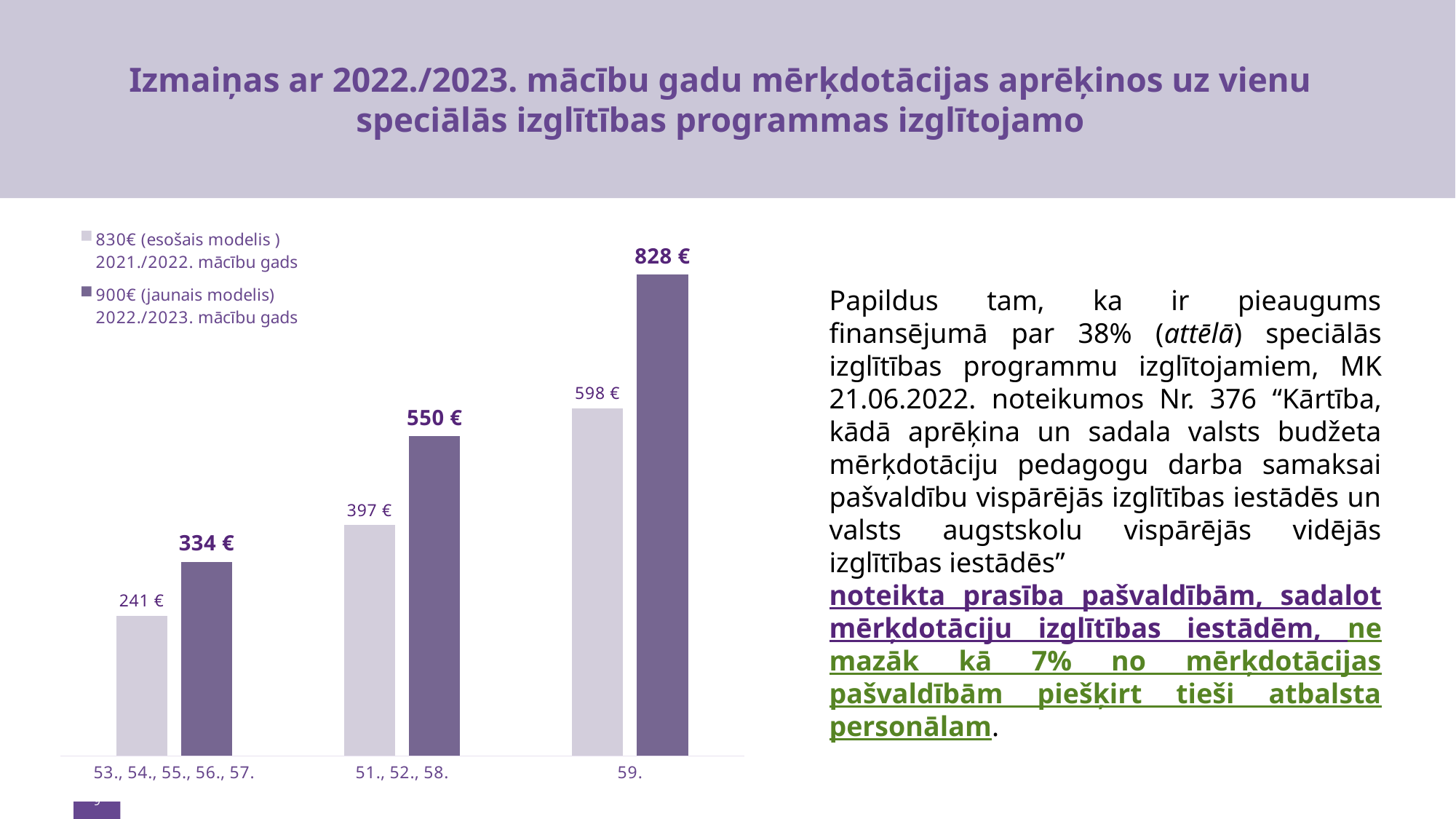
Which category has the lowest value for the 2021./2022. mācību gads series? 53., 54., 55., 56., 57. How many series does the chart legend list? 2 Which category has the highest value for the 2022./2023. mācību gads series? 59. Which is larger in the category "53., 54., 55., 56., 57.": the 2021./2022. value or the 2022./2023. value? 2022./2023. value (334 €) How many categories are shown on the x axis of the chart? 3 Do the values for the 2021./2022. mācību gads series rise or fall from left to right along the x axis? rise What is the value for the 2021./2022. mācību gads series in the category "53., 54., 55., 56., 57."? 241 € What is the value for the 2022./2023. mācību gads series in the category "51., 52., 58."? 550 € What is the value for the 2021./2022. mācību gads series in the category "59."? 598 € What kind of chart is shown on the slide? bar chart What is the value for the 2022./2023. mācību gads series in the category "59."? 828 € What is the difference between the 2022./2023. and 2021./2022. values in the category "51., 52., 58."? 153 €